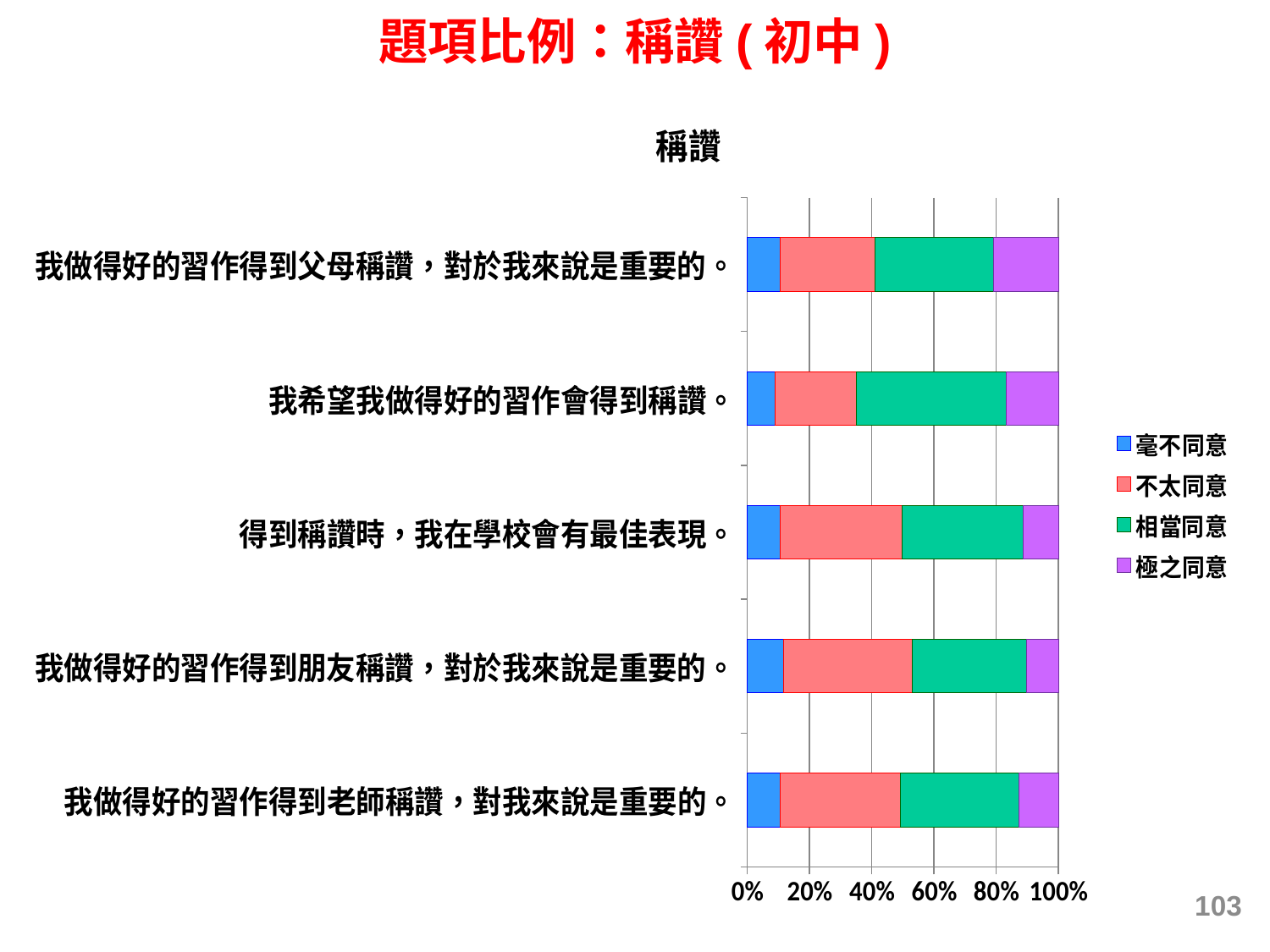
Is the 相當同意 share for 「我做得好的習作得到父母稱讚，對於我來說是重要的。」 greater or less than 20%? greater Which legend entry is shown in green? 相當同意 Is the 相當同意 share larger for 「我希望我做得好的習作會得到稱讚。」 or for 「得到稱讚時，我在學校會有最佳表現。」? 我希望我做得好的習作會得到稱讚。 Is the 相當同意 share for 「我希望我做得好的習作會得到稱讚。」 greater or less than 40%? greater Is the 極之同意 share for 「我希望我做得好的習作會得到稱讚。」 greater or less than 20%? less How many series does the legend list? 4 What is the title shown above the chart? 稱讚 How many statements (categories) are plotted in the chart? 5 Which statement has the largest 相當同意 share? 我希望我做得好的習作會得到稱讚。 What kind of chart is shown on the slide? Stacked bar chart Is the 極之同意 share larger for 「我做得好的習作得到父母稱讚，對於我來說是重要的。」 or for 「得到稱讚時，我在學校會有最佳表現。」? 我做得好的習作得到父母稱讚，對於我來說是重要的。